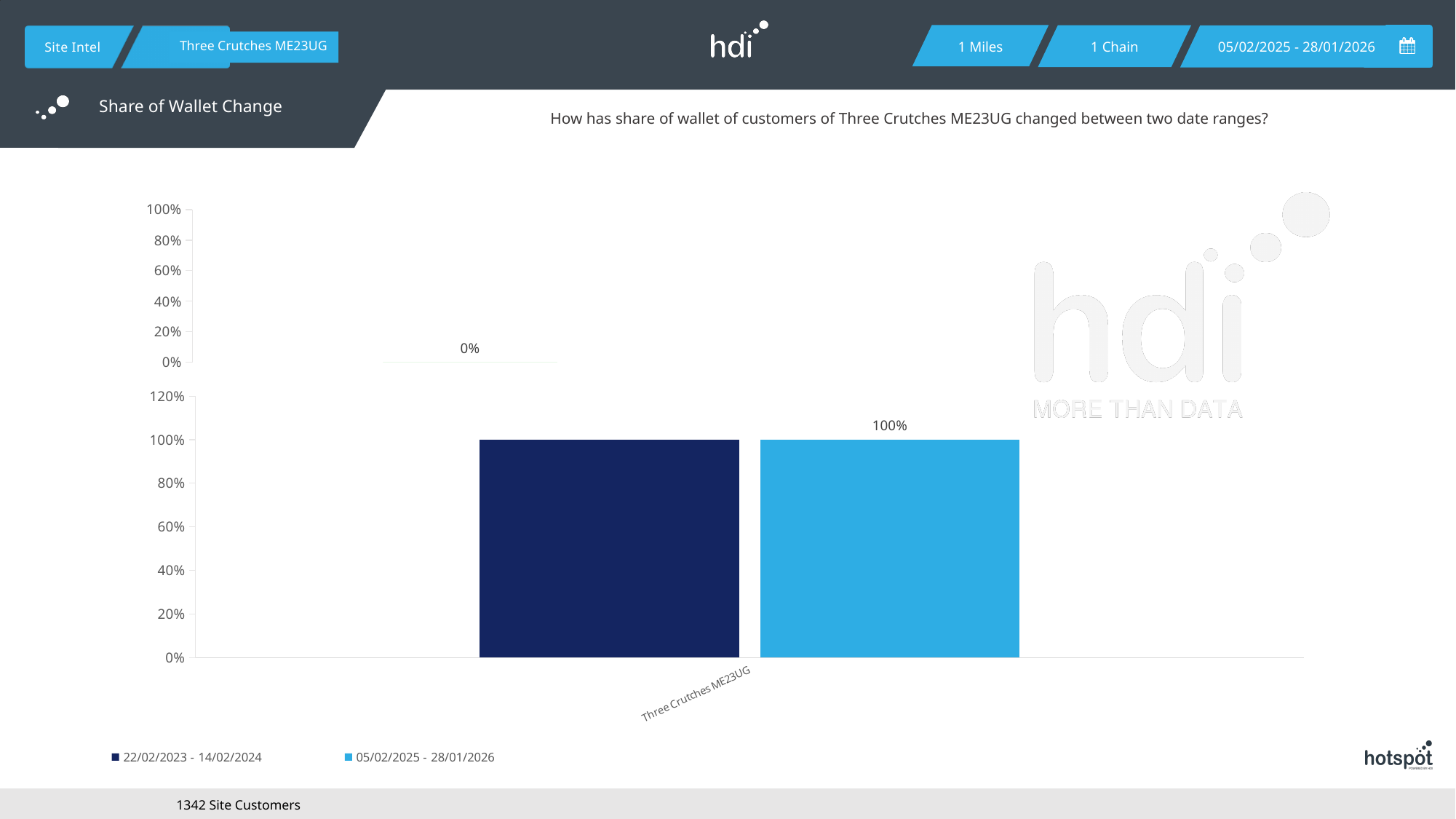
In the bottom chart, what is the value for Three Crutches ME23UG in the 22/02/2023 - 14/02/2024 series? 100% In the top chart, what value is labelled for Three Crutches ME23UG? 0% How many categories are shown on the x axis of the bottom chart? 1 In the bottom chart, what is the value for Three Crutches ME23UG in the 05/02/2025 - 28/01/2026 series? 100% In the bottom chart, is the value for Three Crutches ME23UG in the 22/02/2023 - 14/02/2024 series greater or less than 120%? less What is the category label on the x axis of the bottom chart? Three Crutches ME23UG What kind of chart is the bottom chart? bar chart In the bottom chart, what is the difference between the 22/02/2023 - 14/02/2024 value and the 05/02/2025 - 28/01/2026 value for Three Crutches ME23UG? 0% What is the highest tick shown on the y axis of the bottom chart? 120% In the bottom chart, is the value for Three Crutches ME23UG in the 05/02/2025 - 28/01/2026 series greater or less than 80%? greater Which series in the bottom chart is drawn in dark navy? 22/02/2023 - 14/02/2024 How many series does the legend of the bottom chart list? 2